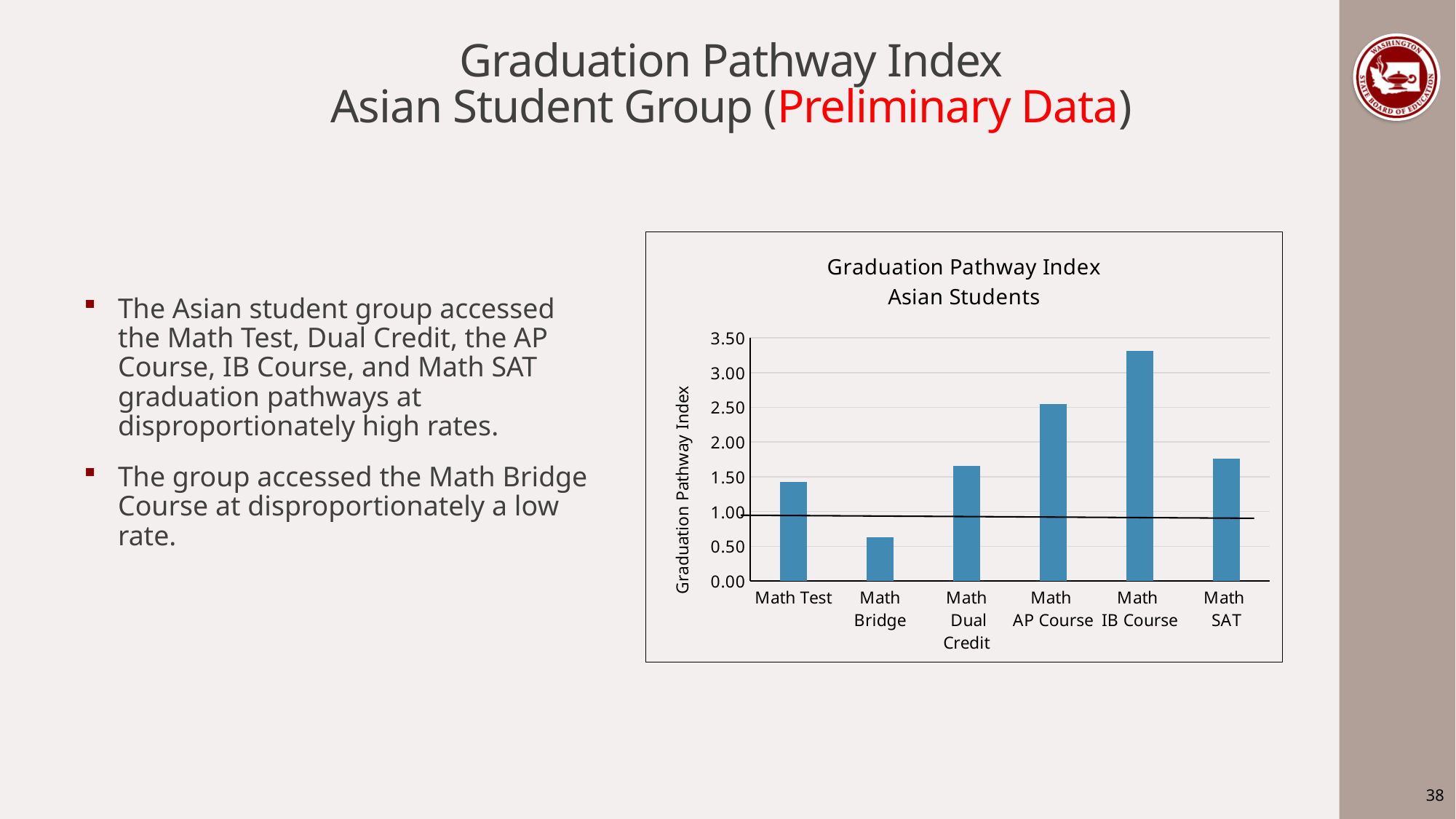
Which graduation pathway has the lowest Graduation Pathway Index? Math Bridge Which has a higher Graduation Pathway Index, Math AP Course or Math SAT? Math AP Course Is the value for Math IB Course greater or less than 3.00? greater Is the value for Math AP Course greater or less than 2.00? greater Which has a higher Graduation Pathway Index, Math Test or Math Bridge? Math Test Is the value for Math SAT greater or less than 1.50? greater How many graduation pathways are shown on the x axis of the chart? 6 Which graduation pathway has the highest Graduation Pathway Index? Math IB Course What kind of chart is shown on the slide? bar chart What is the label on the vertical axis of the chart? Graduation Pathway Index